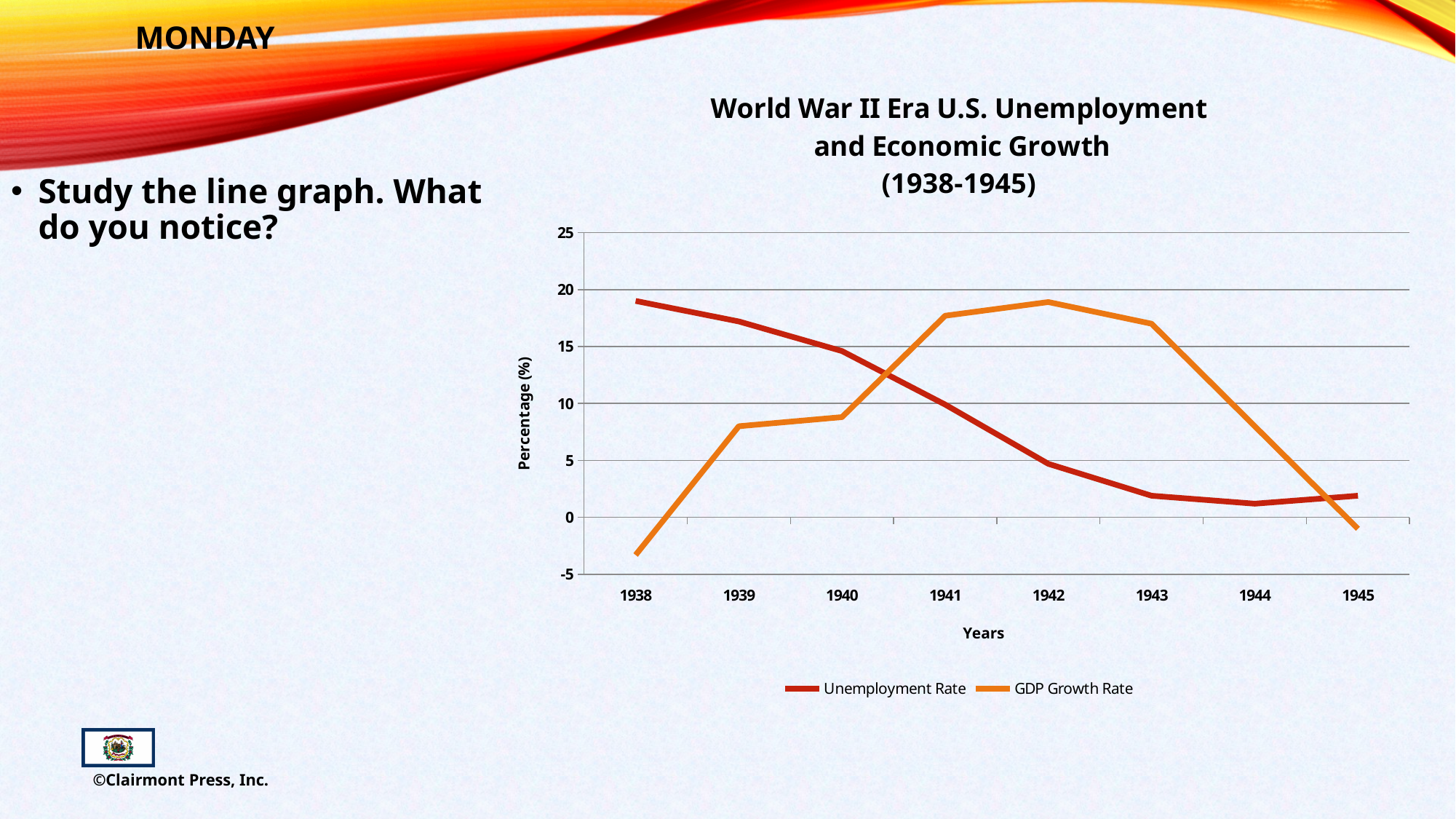
In which year is the GDP Growth Rate lowest? 1938 How many series does the legend list? 2 What kind of chart is shown on the slide? Line chart What is the label of the y axis? Percentage (%) Is the GDP Growth Rate in 1941 greater or less than 15? greater In which year is the Unemployment Rate highest? 1938 Is the Unemployment Rate in 1938 greater or less than 15? greater How many years are plotted along the x axis? 8 Does the Unemployment Rate rise or fall from 1938 to 1944? Fall Is the GDP Growth Rate in 1945 greater or less than 0? less In 1942, which is larger: the Unemployment Rate or the GDP Growth Rate? GDP Growth Rate In which year is the GDP Growth Rate highest? 1942